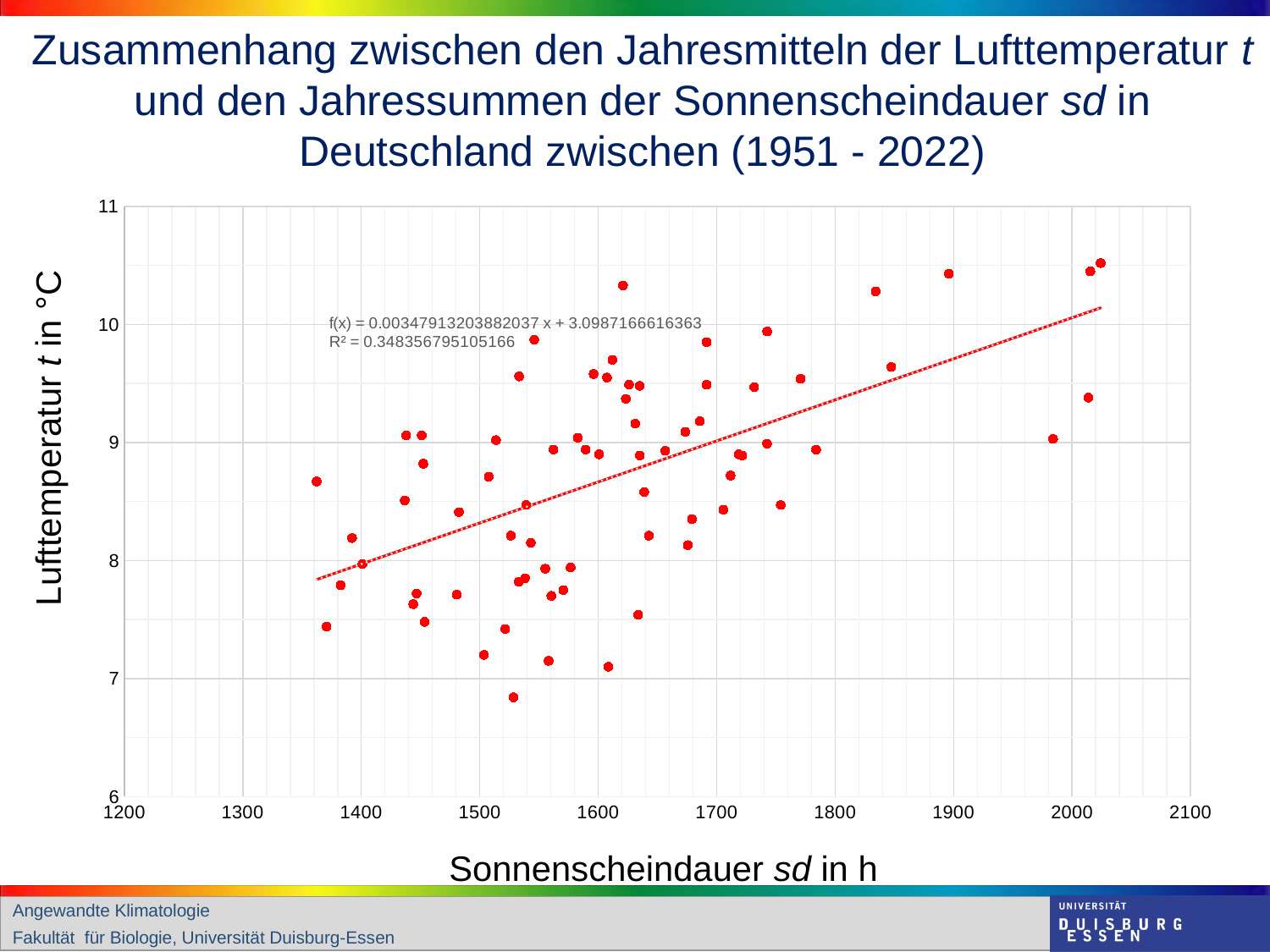
Is the temperature of the lowest point on the chart greater or less than 7? less Do the air temperature values generally rise or fall as sunshine duration increases along the x axis? rise What is the R² value printed on the chart? 0.348356795105166 Is the sunshine duration of the rightmost points on the chart greater or less than 2000? greater What is the equation of the trend line printed on the chart? f(x) = 0.00347913203882037 x + 3.0987166616363 Is the temperature of the point near 1985 h sunshine duration greater or less than 10? less Which is larger: the temperature of the highest point near 2020 h or the temperature of the point near 1985 h? the point near 2020 h What kind of chart is shown on the slide? scatter plot